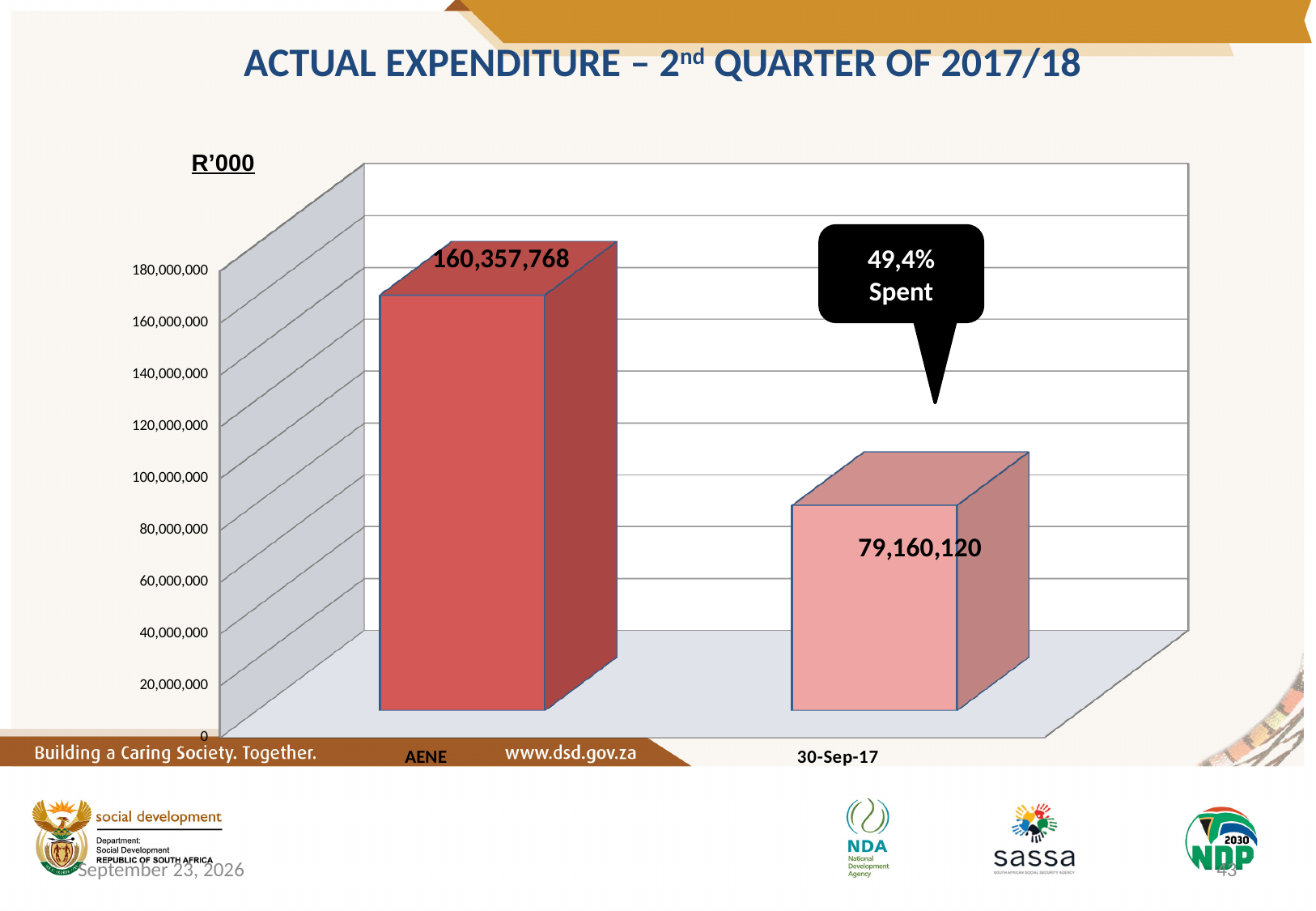
Is the value for 30-Sep-17 greater or less than 100,000,000? less How many categories are shown on the x axis? 2 What percentage spent is shown in the callout on the chart? 49,4% What is the value for 30-Sep-17? 79,160,120 Is the value for AENE greater or less than 140,000,000? greater What kind of chart is shown on the slide? bar chart Which category has the lowest value? 30-Sep-17 What unit label is shown above the vertical axis of the chart? R'000 Which is larger, the value for AENE or the value for 30-Sep-17? AENE What is the value for AENE? 160,357,768 What is the difference between the AENE value and the 30-Sep-17 value? 81,197,648 Which category has the highest value? AENE